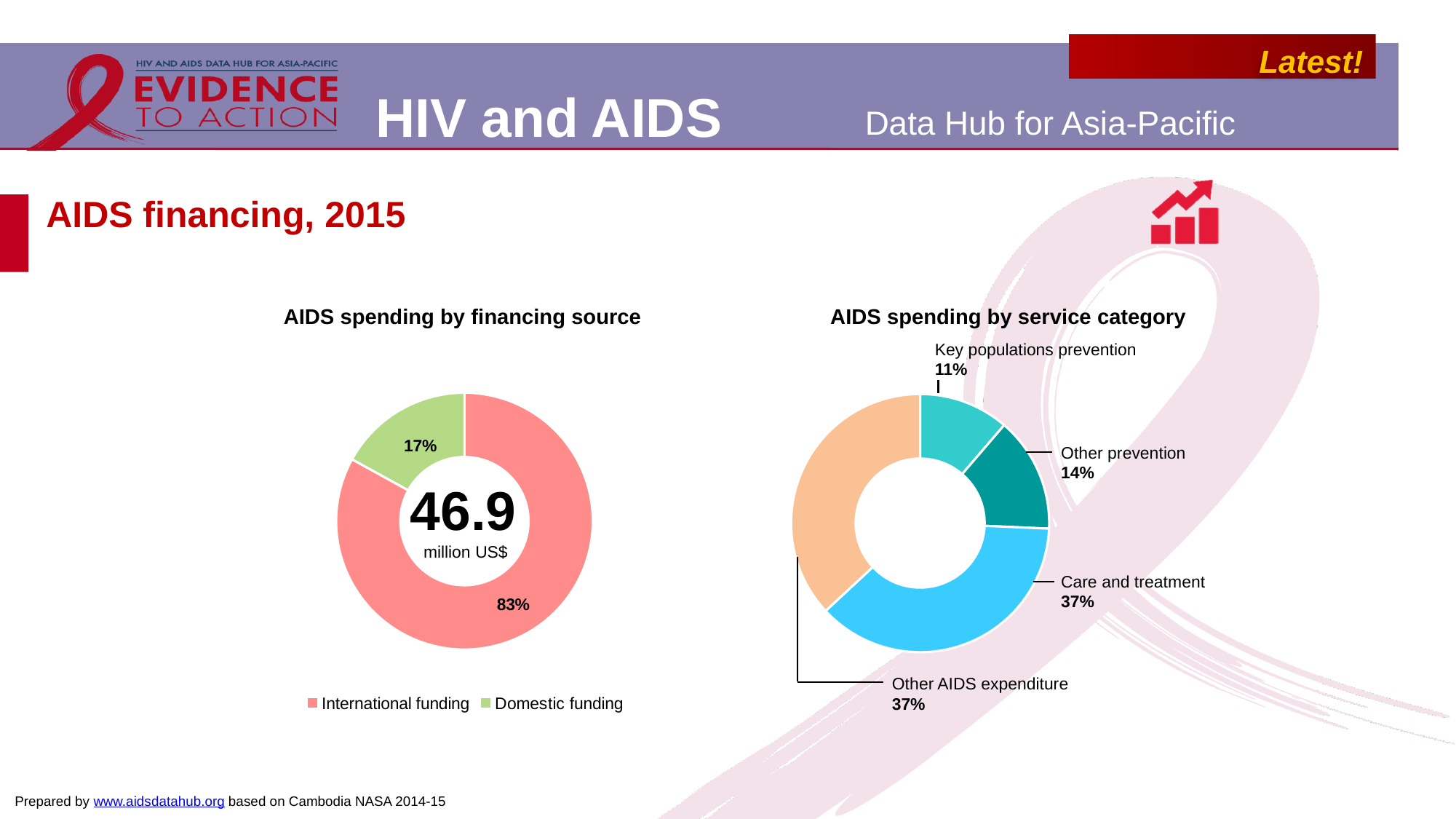
What kind of chart is 'AIDS spending by service category'? Pie (donut) chart In the 'AIDS spending by service category' chart, how many service categories are shown? 4 In the 'AIDS spending by service category' chart, what share is Care and treatment? 37% In the 'AIDS spending by financing source' chart, which funding source has the larger share? International funding In the 'AIDS spending by financing source' chart, what is the difference in percentage points between International funding and Domestic funding? 66 percentage points In the 'AIDS spending by financing source' chart, what share is International funding? 83% In the 'AIDS spending by service category' chart, what share is Key populations prevention? 11% In the 'AIDS spending by financing source' chart, how many entries does the legend list? 2 In the 'AIDS spending by service category' chart, which category has the smallest share? Key populations prevention In the 'AIDS spending by financing source' chart, what total amount is shown in the centre of the donut? 46.9 million US$